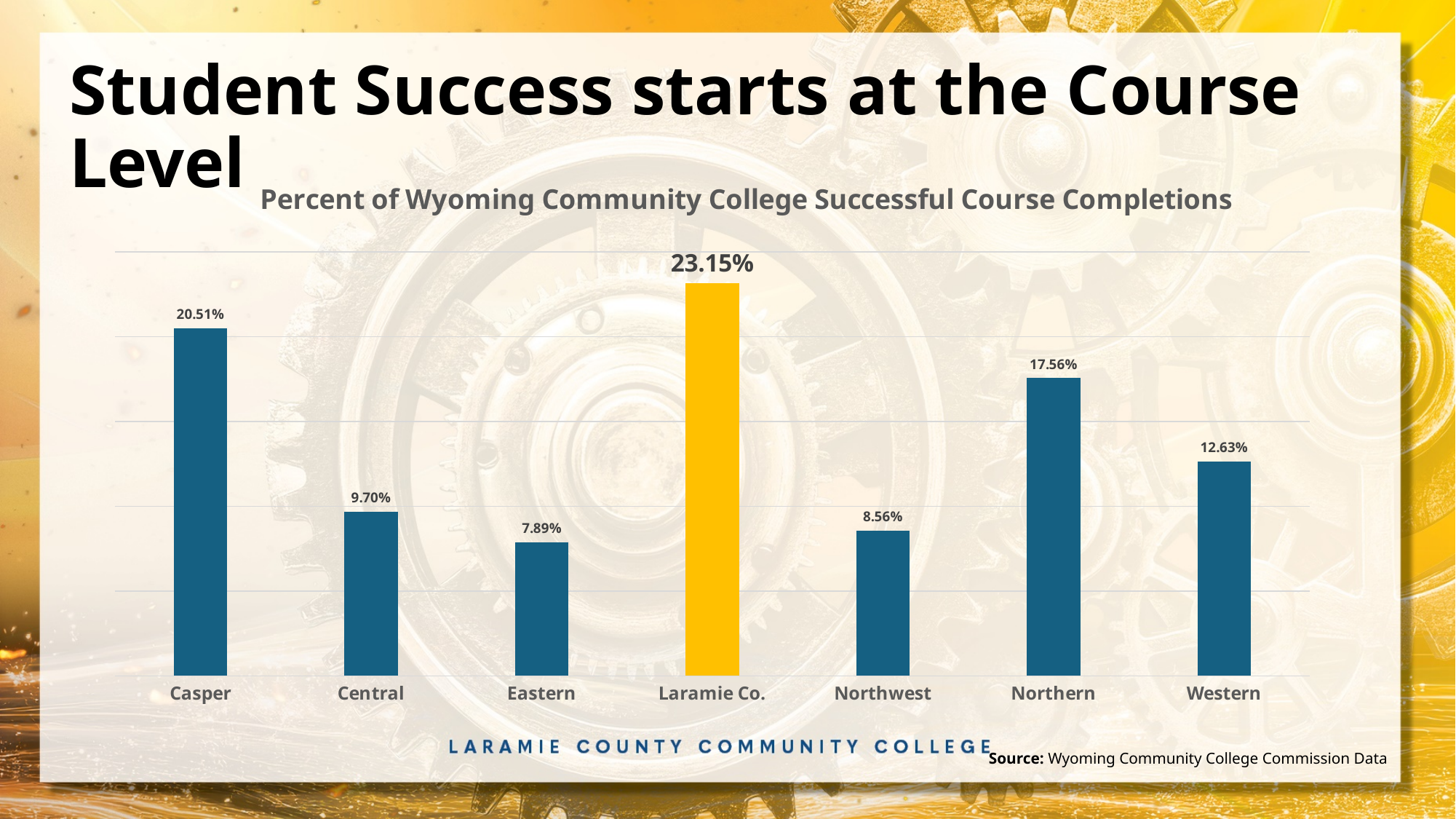
What is the difference between the values for Northern and Western? 4.93% What is the value for Laramie Co.? 23.15% What is the title of the chart? Percent of Wyoming Community College Successful Course Completions Which category has the lowest value? Eastern Which is larger, the value for Central or the value for Northwest? Central What is the value for Western? 12.63% What kind of chart is shown on the slide? Bar chart How many categories are shown on the chart? 7 What is the difference between the values for Laramie Co. and Casper? 2.64% Which category has the highest value? Laramie Co. What is the value for Northwest? 8.56% What is the value for Casper? 20.51%